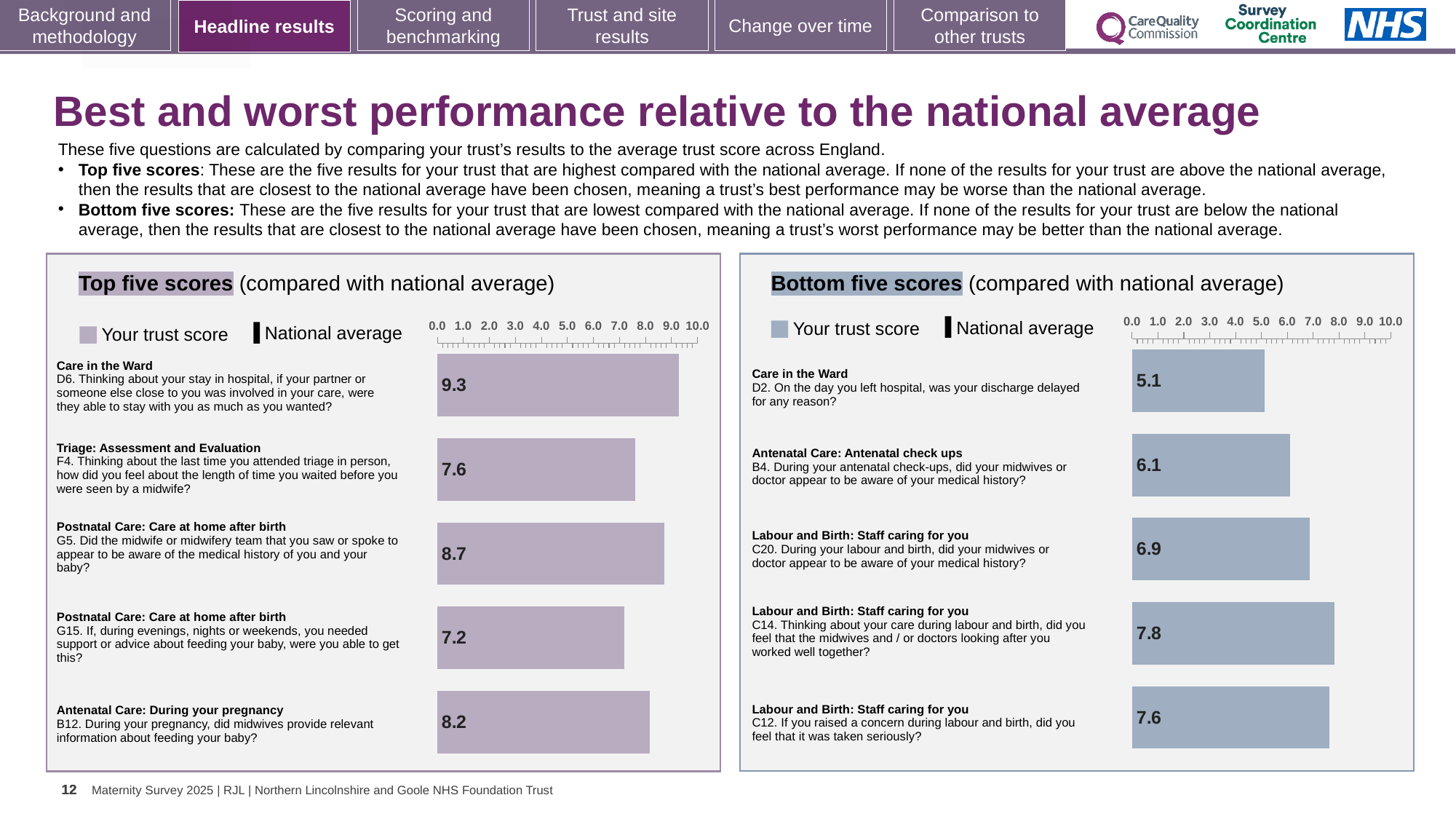
In the Top five scores chart, what is the trust score for question D6 (Care in the Ward)? 9.3 In the Top five scores chart, what is the trust score for question G5 (Postnatal Care: Care at home after birth)? 8.7 In the Bottom five scores chart, what is the trust score for question D2 (Care in the Ward)? 5.1 In the Top five scores chart, what is the difference between the trust scores for D6 and G15? 2.1 In the Bottom five scores chart, which question has the highest trust score? C14 (Labour and Birth: Staff caring for you) In the Bottom five scores chart, is the trust score for B4 greater or less than 5.0? greater In the Bottom five scores chart, which has the larger trust score, C14 or C12? C14 In the Bottom five scores chart, which question has the lowest trust score? D2 (Care in the Ward) How many bars are plotted in the Top five scores chart? 5 What kind of chart is the Bottom five scores chart? Bar chart In the Top five scores chart, which question has the highest trust score? D6 (Care in the Ward) In the Bottom five scores chart, what is the difference between the trust scores for C14 and D2? 2.7